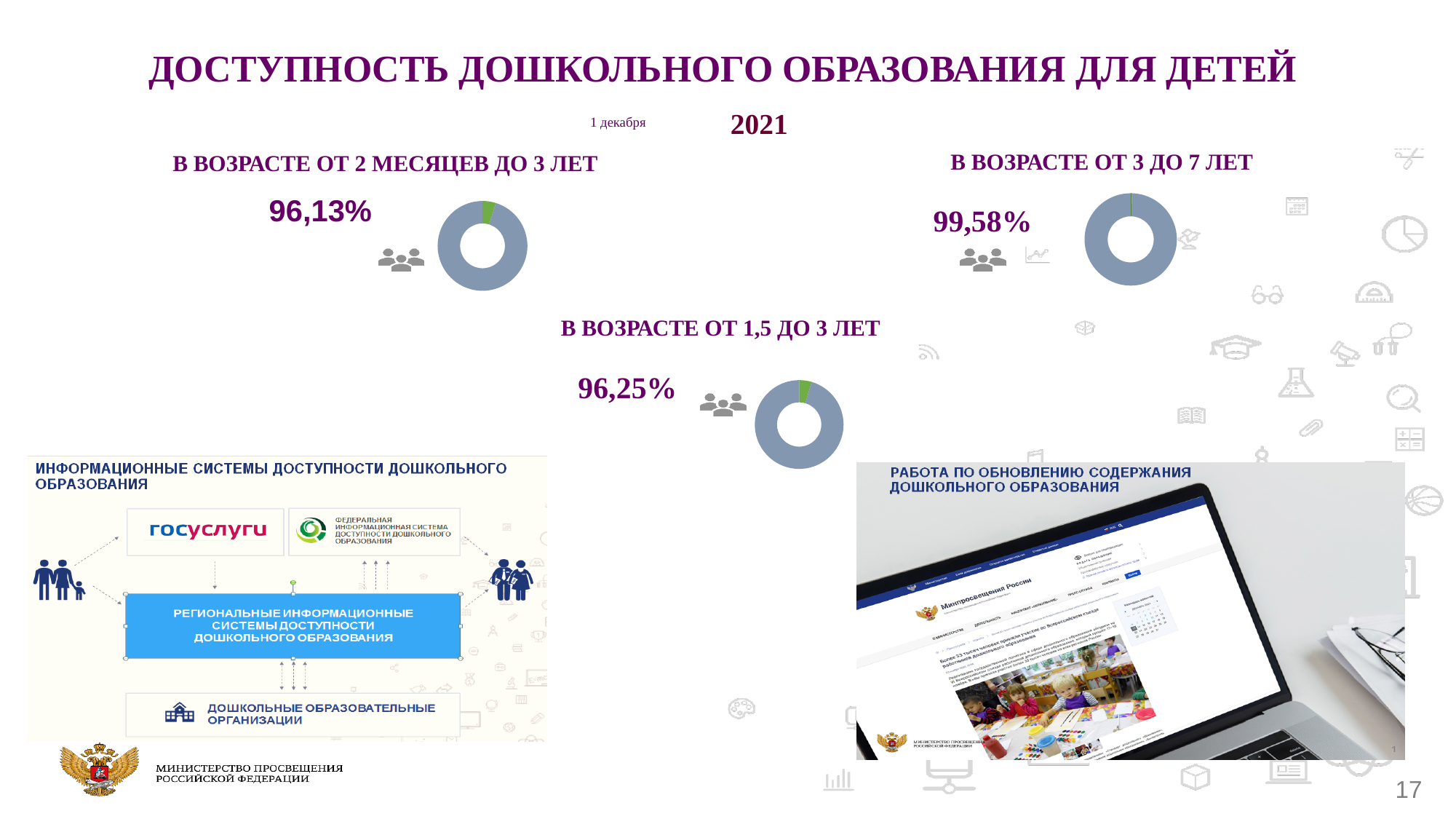
What is the value shown for the chart titled 'В ВОЗРАСТЕ ОТ 1,5 ДО 3 ЛЕТ'? 96,25% Which is larger: the percentage for ages 3 to 7 or the percentage for ages 2 months to 3 years? Ages 3 to 7 (99,58%) What colour is the large filled portion of each donut chart? Grey-blue What is the value shown for the chart titled 'В ВОЗРАСТЕ ОТ 2 МЕСЯЦЕВ ДО 3 ЛЕТ'? 96,13% What is the difference between the percentage for ages 1,5 to 3 years and the percentage for ages 2 months to 3 years? 0,12% What kind of chart is used to show the percentages on this slide? Donut (pie) chart Which age group chart shows the highest percentage? В ВОЗРАСТЕ ОТ 3 ДО 7 ЛЕТ What is the difference between the percentage for ages 3 to 7 and the percentage for ages 2 months to 3 years? 3,45% How many donut charts are shown on the slide? 3 Which age group chart shows the lowest percentage? В ВОЗРАСТЕ ОТ 2 МЕСЯЦЕВ ДО 3 ЛЕТ What is the difference between the percentage for ages 3 to 7 and the percentage for ages 1,5 to 3 years? 3,33% What is the value shown for the chart titled 'В ВОЗРАСТЕ ОТ 3 ДО 7 ЛЕТ'? 99,58%